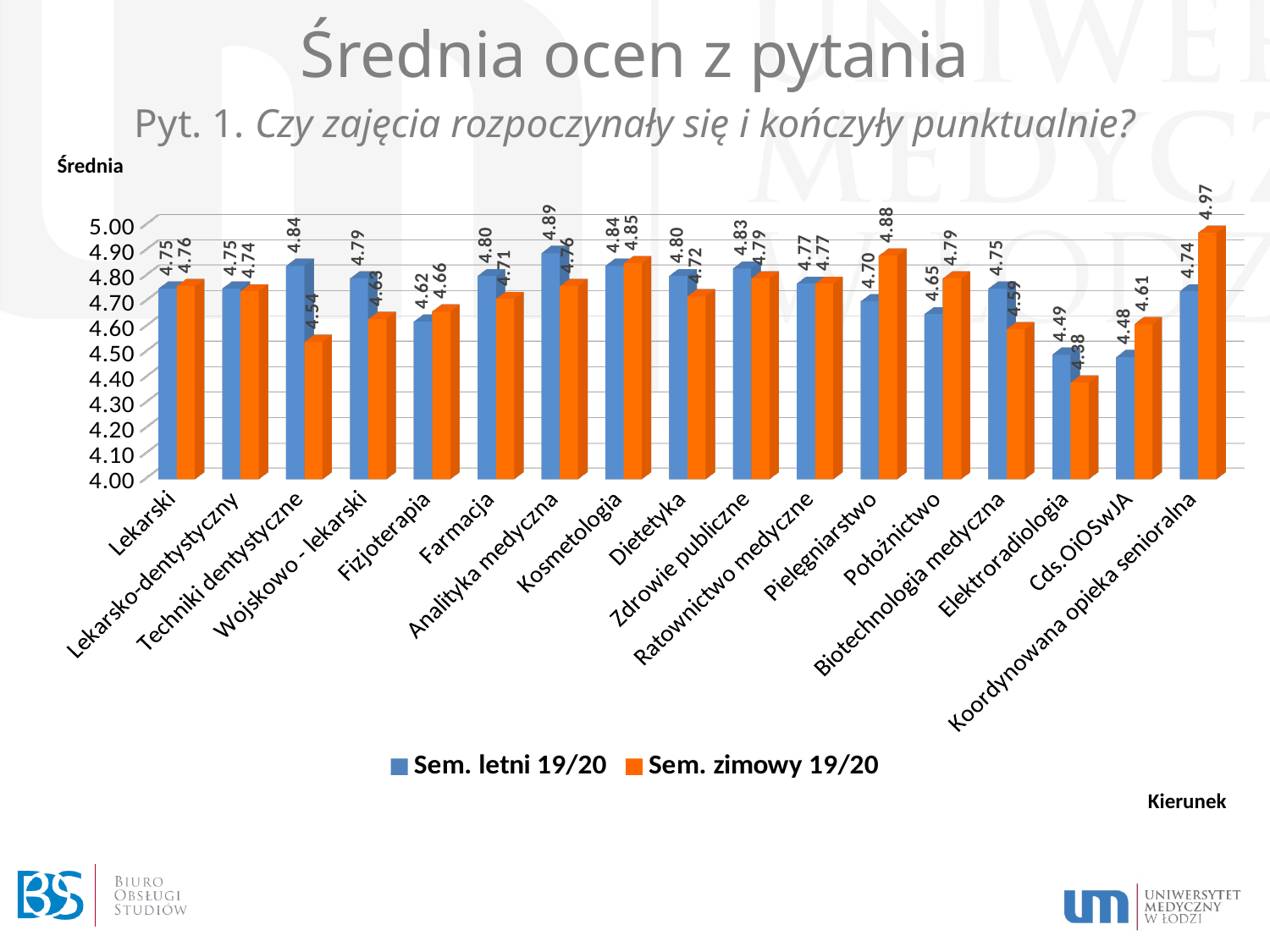
Which category has the lowest value in Sem. letni 19/20? Cds.OiOSwJA How many categories (kierunki) are shown on the x axis? 17 What is the value for Koordynowana opieka senioralna in Sem. zimowy 19/20? 4.97 Which is larger for Techniki dentystyczne: Sem. letni 19/20 or Sem. zimowy 19/20? Sem. letni 19/20 Which category has the lowest value in Sem. zimowy 19/20? Elektroradiologia Is the value for Elektroradiologia in Sem. letni 19/20 greater or less than 4.60? less What is the value for Analityka medyczna in Sem. letni 19/20? 4.89 What is the value for Pielęgniarstwo in Sem. zimowy 19/20? 4.88 What is the difference between the Sem. zimowy 19/20 and Sem. letni 19/20 values for Koordynowana opieka senioralna? 0.23 Which category has the highest value in Sem. letni 19/20? Analityka medyczna How many series does the legend list? 2 What kind of chart is shown on the slide? Bar chart